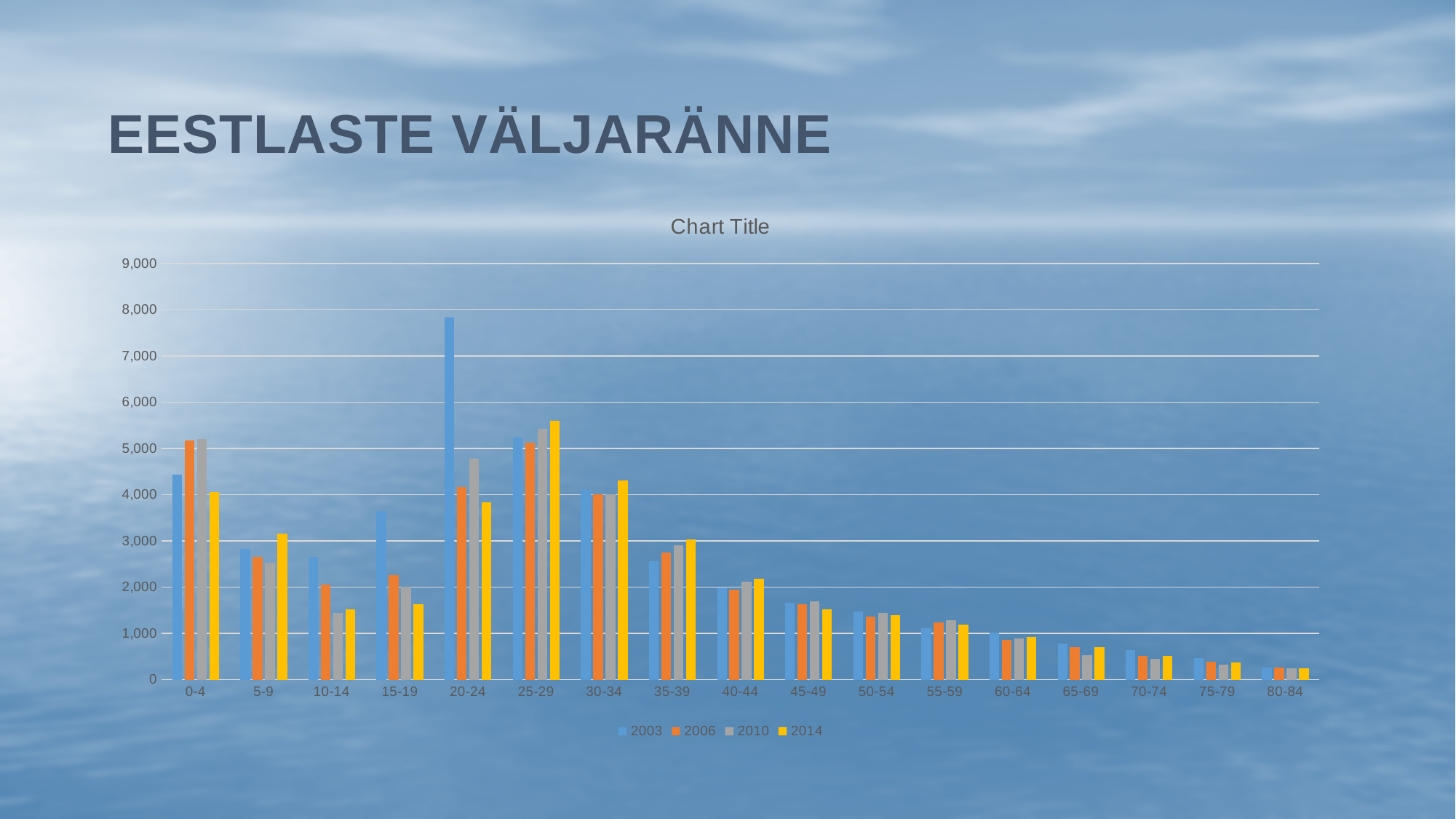
Is the 2014 value for the 25-29 age group greater or less than 5,000? greater Is the 2003 value for the 10-14 age group greater or less than 3,000? less Do the 2003 values rise or fall from the 25-29 age group to the 80-84 age group? fall What type of chart is shown on the slide? bar chart For the 15-19 age group, which series has the larger value, 2003 or 2014? 2003 Which age group has the lowest value for the 2003 series? 80-84 How many series does the legend list? 4 Is the 2003 value for the 20-24 age group greater or less than 7,000? greater How many age-group categories are shown on the x axis? 17 For the 0-4 age group, which series has the larger value, 2003 or 2006? 2006 Which age group has the highest value for the 2014 series? 25-29 Which age group has the highest value for the 2003 series? 20-24